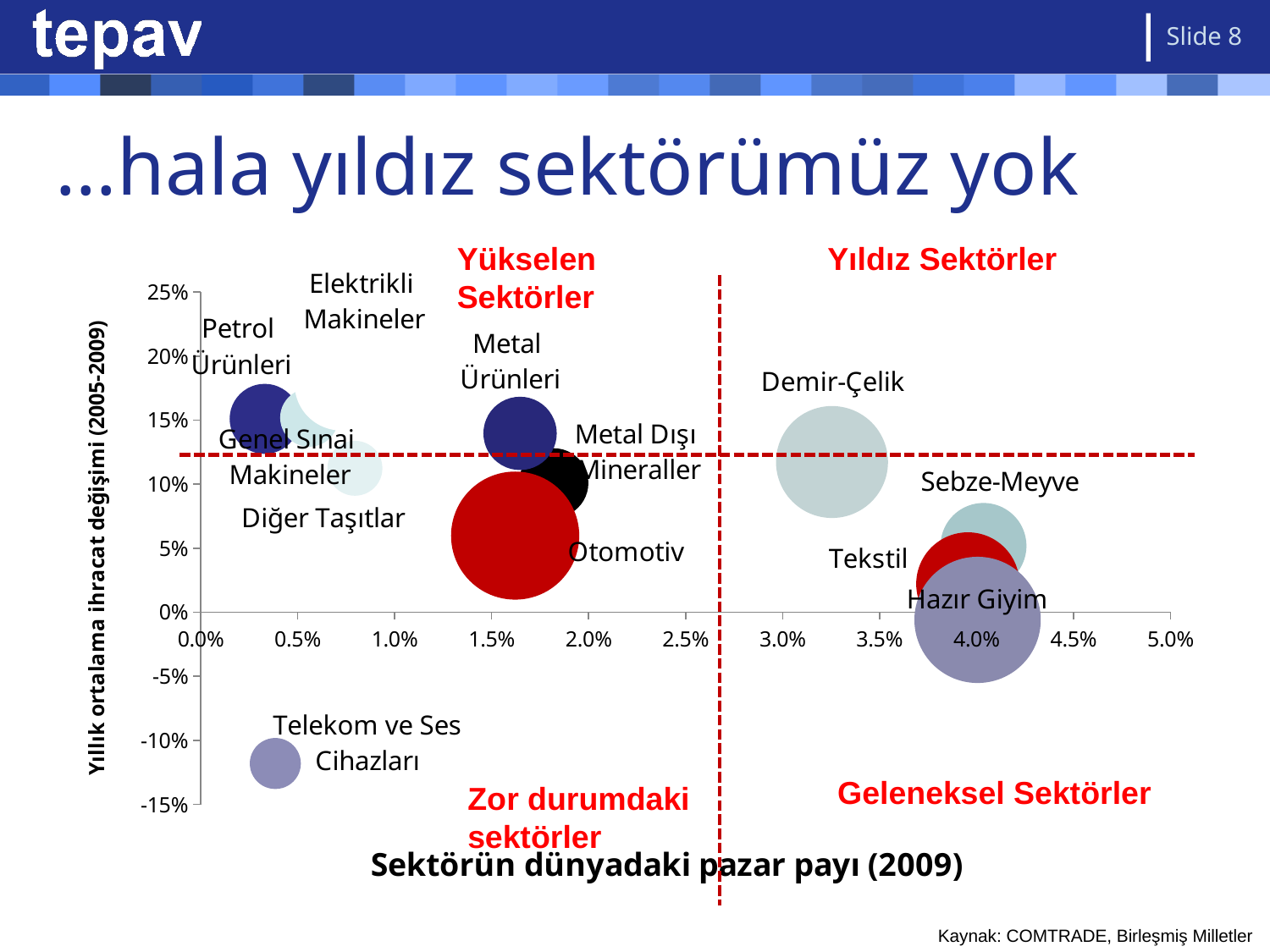
Is the world market share for Telekom ve Ses Cihazları greater or less than 1.0%? less Is the annual average export change for Petrol Ürünleri greater or less than 10%? greater Which has the larger world market share, Hazır Giyim or Telekom ve Ses Cihazları? Hazır Giyim Which sector has the lowest annual average export change on the chart? Telekom ve Ses Cihazları Is the annual average export change for Otomotiv greater or less than 10%? less What is the title of the chart's vertical axis? Yıllık ortalama ihracat değişimi (2005-2009) Which has the higher annual average export change, Otomotiv or Telekom ve Ses Cihazları? Otomotiv What is the title of the chart's horizontal axis? Sektörün dünyadaki pazar payı (2009) What kind of chart is shown on the slide? bubble chart